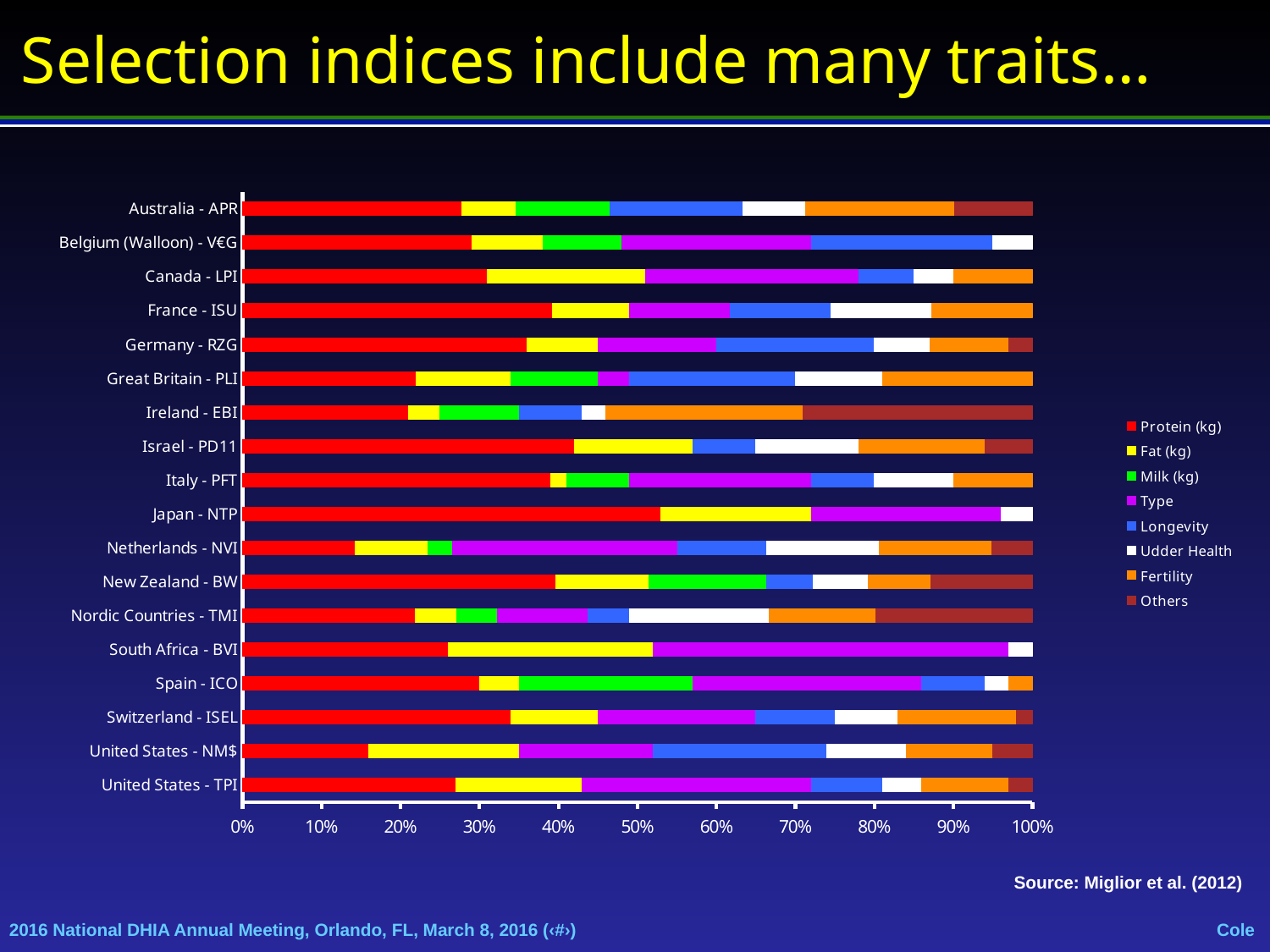
Is the Protein (kg) share for Netherlands - NVI greater or less than 20%? less How many series does the legend list? 8 Which index has the largest Type share? South Africa - BVI Is the Protein (kg) share for France - ISU greater or less than 30%? greater Which index has the largest Others share? Ireland - EBI What does each stacked bar total, according to the x axis? 100% Which has the larger Protein (kg) share, Japan - NTP or Netherlands - NVI? Japan - NTP How many selection indices (categories) are plotted on the chart? 18 Is the Protein (kg) share for Japan - NTP greater or less than 50%? greater What is the first entry listed in the chart legend? Protein (kg) What kind of chart is shown on the slide? Stacked bar chart Which index has the largest Protein (kg) share? Japan - NTP